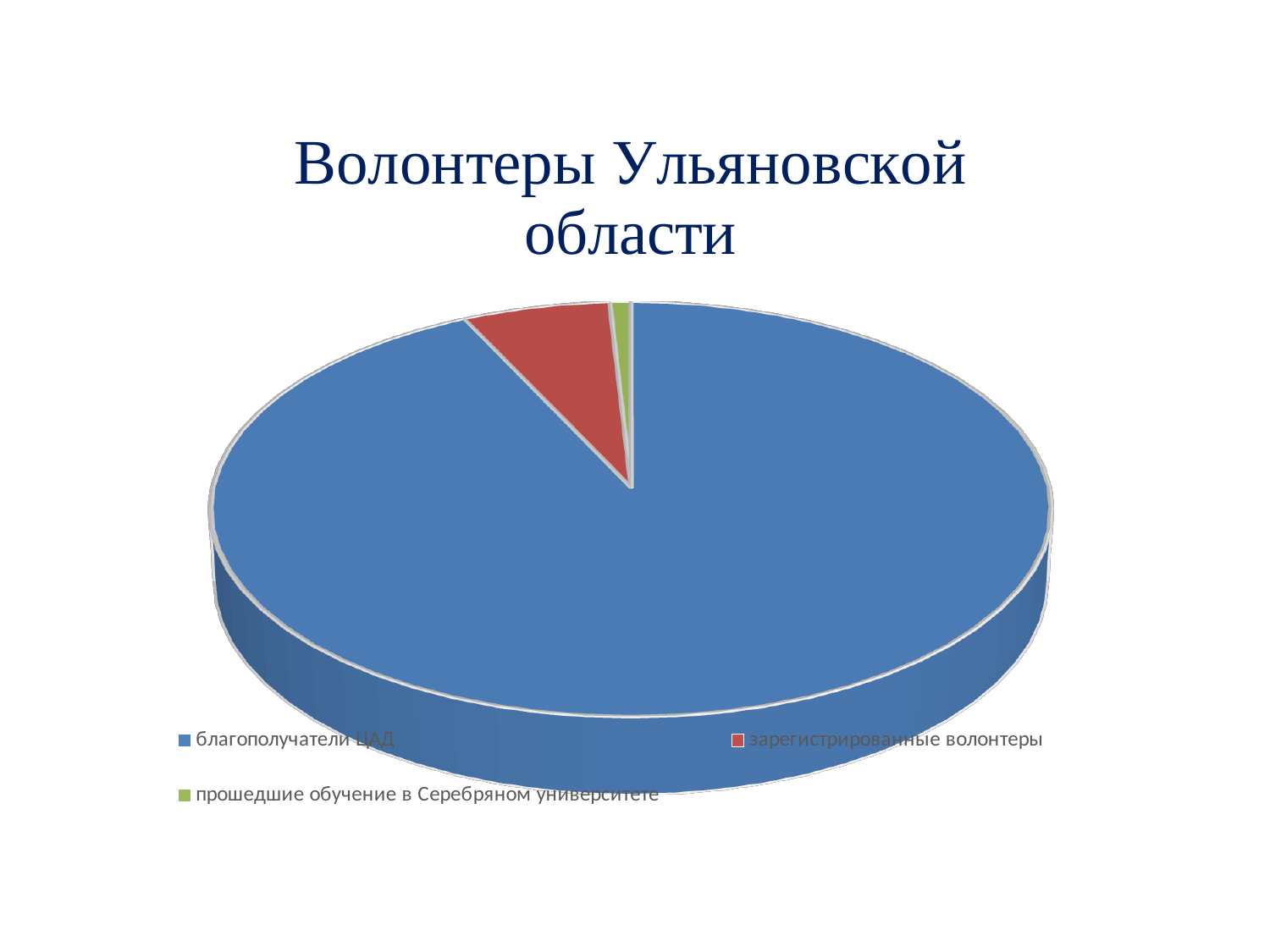
Which category has the largest slice of the pie? благополучатели ЦАД How many entries does the legend list? 3 Which category is shown in blue? благополучатели ЦАД What kind of chart is shown on the slide? pie chart How many slices does the pie chart have? 3 Which category has the smallest slice of the pie? прошедшие обучение в Серебряном университете Which slice is larger: благополучатели ЦАД or зарегистрированные волонтеры? благополучатели ЦАД What is the title of the chart? Волонтеры Ульяновской области What colour is the slice for зарегистрированные волонтеры? red Which slice is larger: зарегистрированные волонтеры or прошедшие обучение в Серебряном университете? зарегистрированные волонтеры